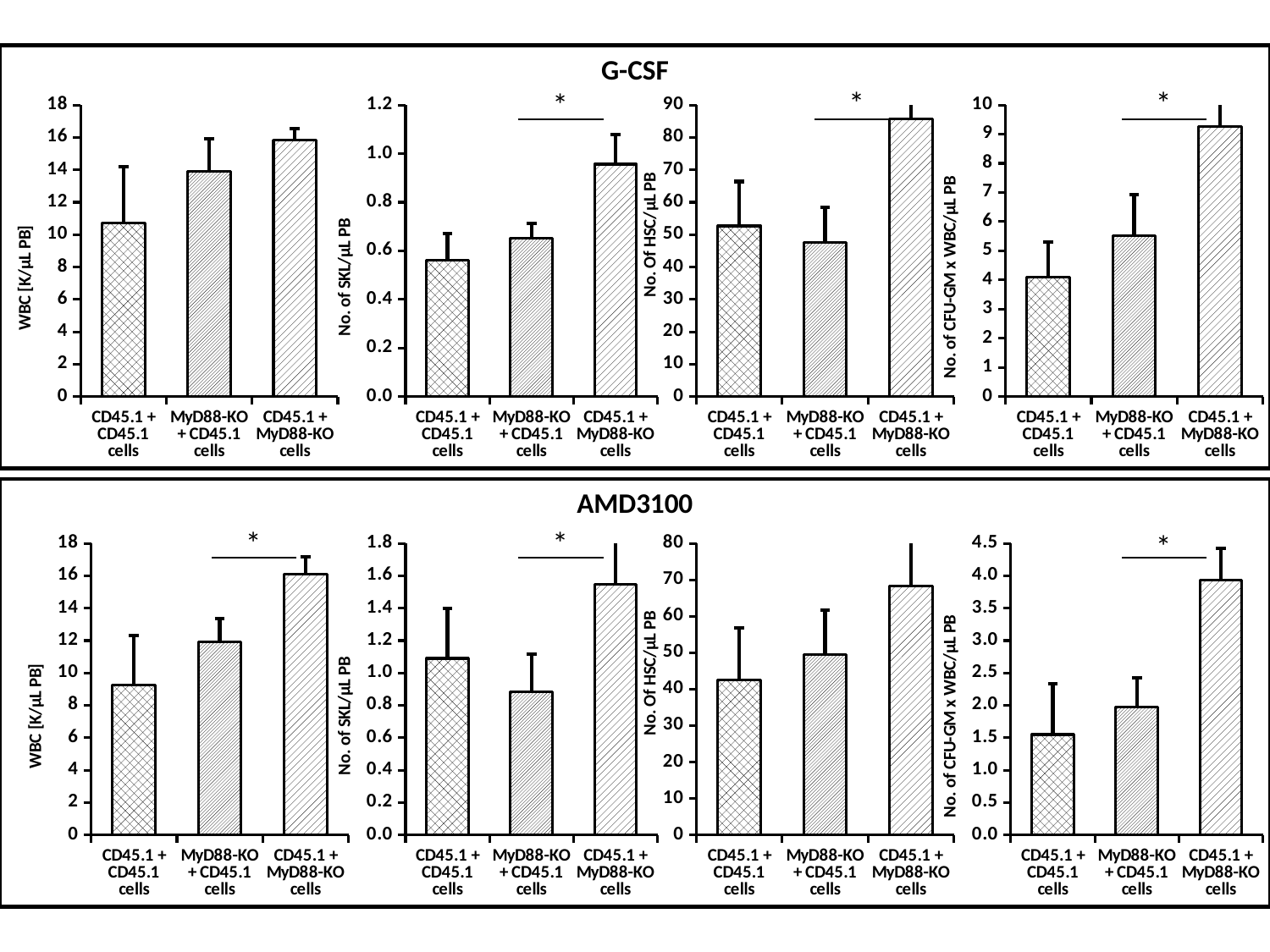
In the AMD3100 panel, in the chart with y-axis 'No. of CFU-GM x WBC/µL PB', is the value for CD45.1 + MyD88-KO cells greater or less than 3.5? greater In the AMD3100 panel, in the chart with y-axis 'WBC [K/µL PB]', do the values rise or fall from left to right? rise How many categories are shown in the AMD3100 chart with y-axis 'No. Of HSC/µL PB'? 3 In the AMD3100 panel, in the chart with y-axis 'No. of SKL/µL PB', which is larger, CD45.1 + CD45.1 cells or MyD88-KO + CD45.1 cells? CD45.1 + CD45.1 cells In the G-CSF panel, in the chart with y-axis 'WBC [K/µL PB]', which category has the lowest bar? CD45.1 + CD45.1 cells In the G-CSF panel, in the chart with y-axis 'No. of SKL/µL PB', is the value for CD45.1 + MyD88-KO cells greater or less than 0.8? greater In the G-CSF panel, in the chart with y-axis 'WBC [K/µL PB]', which category has the highest bar? CD45.1 + MyD88-KO cells In the G-CSF panel, in the chart with y-axis 'No. of CFU-GM x WBC/µL PB', which category has the highest bar? CD45.1 + MyD88-KO cells In the G-CSF panel, in the chart with y-axis 'No. Of HSC/µL PB', is the value for CD45.1 + MyD88-KO cells greater or less than 80? greater What kind of chart is the G-CSF chart with y-axis 'No. of SKL/µL PB'? bar chart